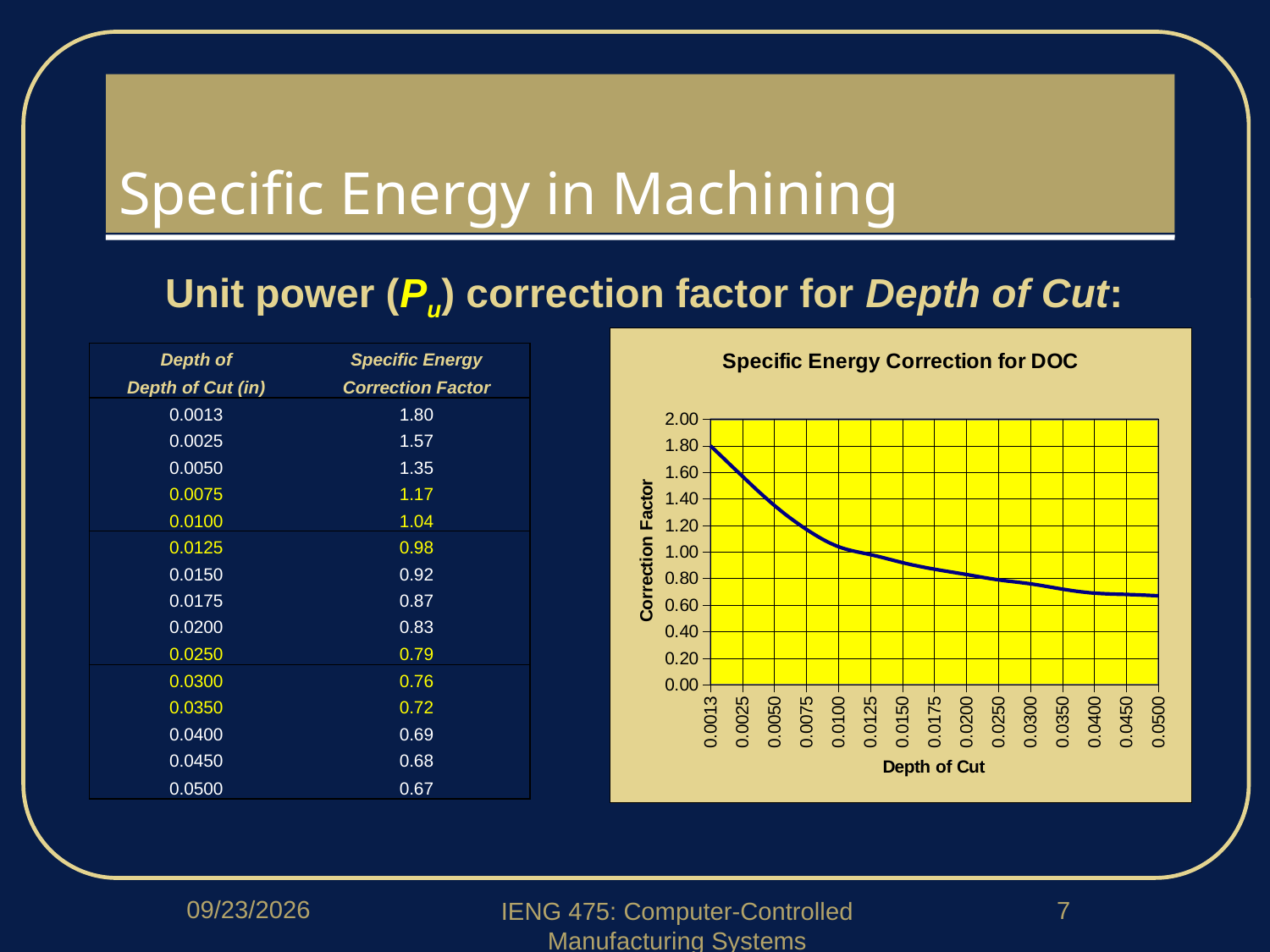
What kind of chart is shown on the slide? line chart At which depth of cut is the correction factor lowest? 0.0500 Which has the larger correction factor, a depth of cut of 0.0050 or 0.0200? 0.0050 How many depth-of-cut points are plotted on the chart? 15 Is the correction factor at a depth of cut of 0.0500 greater or less than 0.80? less At which depth of cut is the correction factor highest? 0.0013 Does the correction factor rise or fall as depth of cut increases along the x axis? fall What is the correction factor at a depth of cut of 0.0013? 1.80 What is the difference between the correction factor at 0.0013 and at 0.0500? 1.13 What is the label of the y axis of the chart? Correction Factor What is the correction factor at a depth of cut of 0.0500? 0.67 What is the title of the chart? Specific Energy Correction for DOC